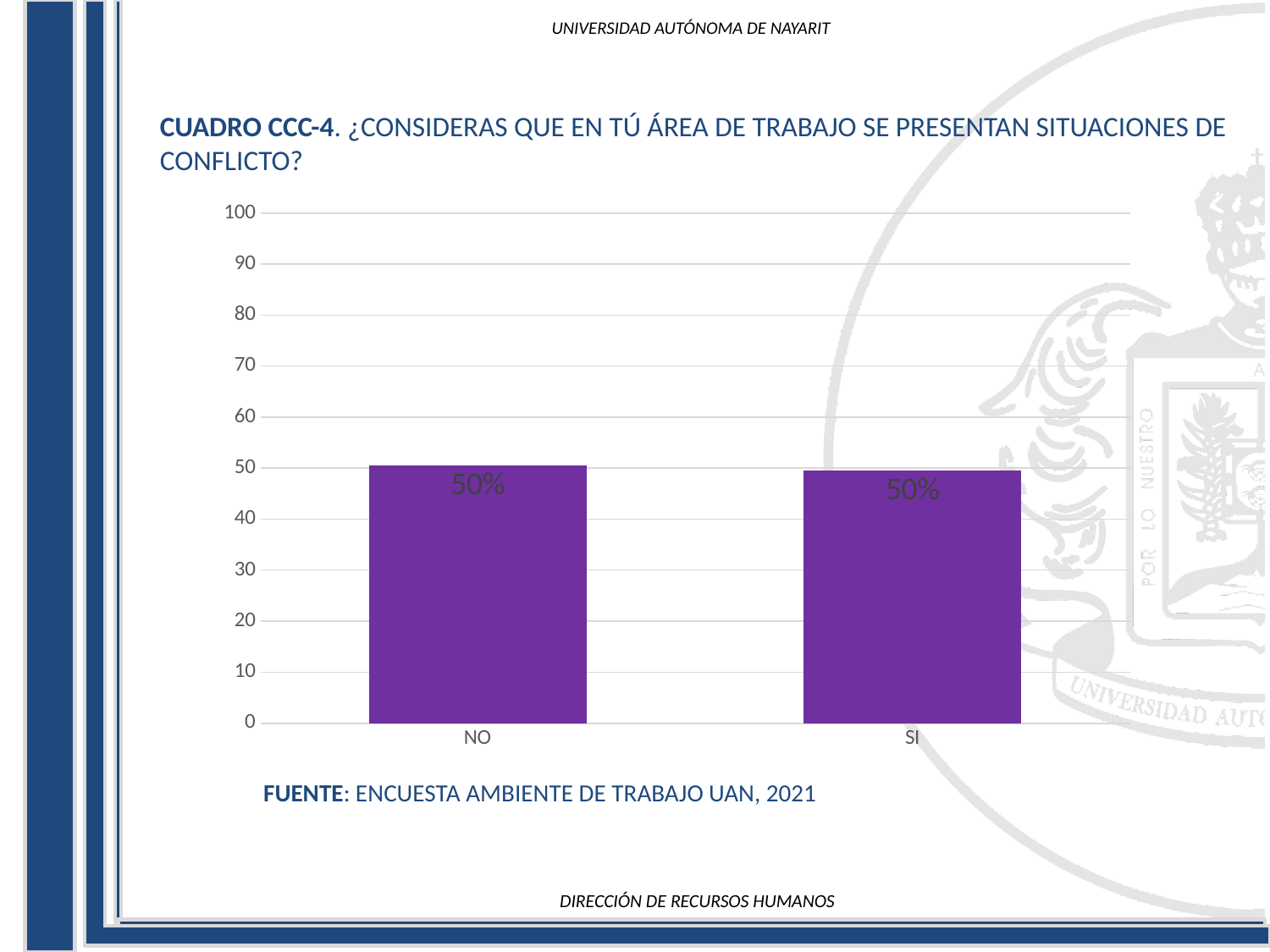
What source is cited below the chart? ENCUESTA AMBIENTE DE TRABAJO UAN, 2021 What kind of chart is shown on the slide? bar chart What is the highest value shown on the y axis? 100 What is the value for SI? 50% How many categories are shown on the x axis? 2 What are the two category labels on the x axis? NO and SI Is the value for SI greater or less than 60? less What is the difference between the values for NO and SI? 0% Is the value for NO greater or less than 40? greater What is the value for NO? 50%